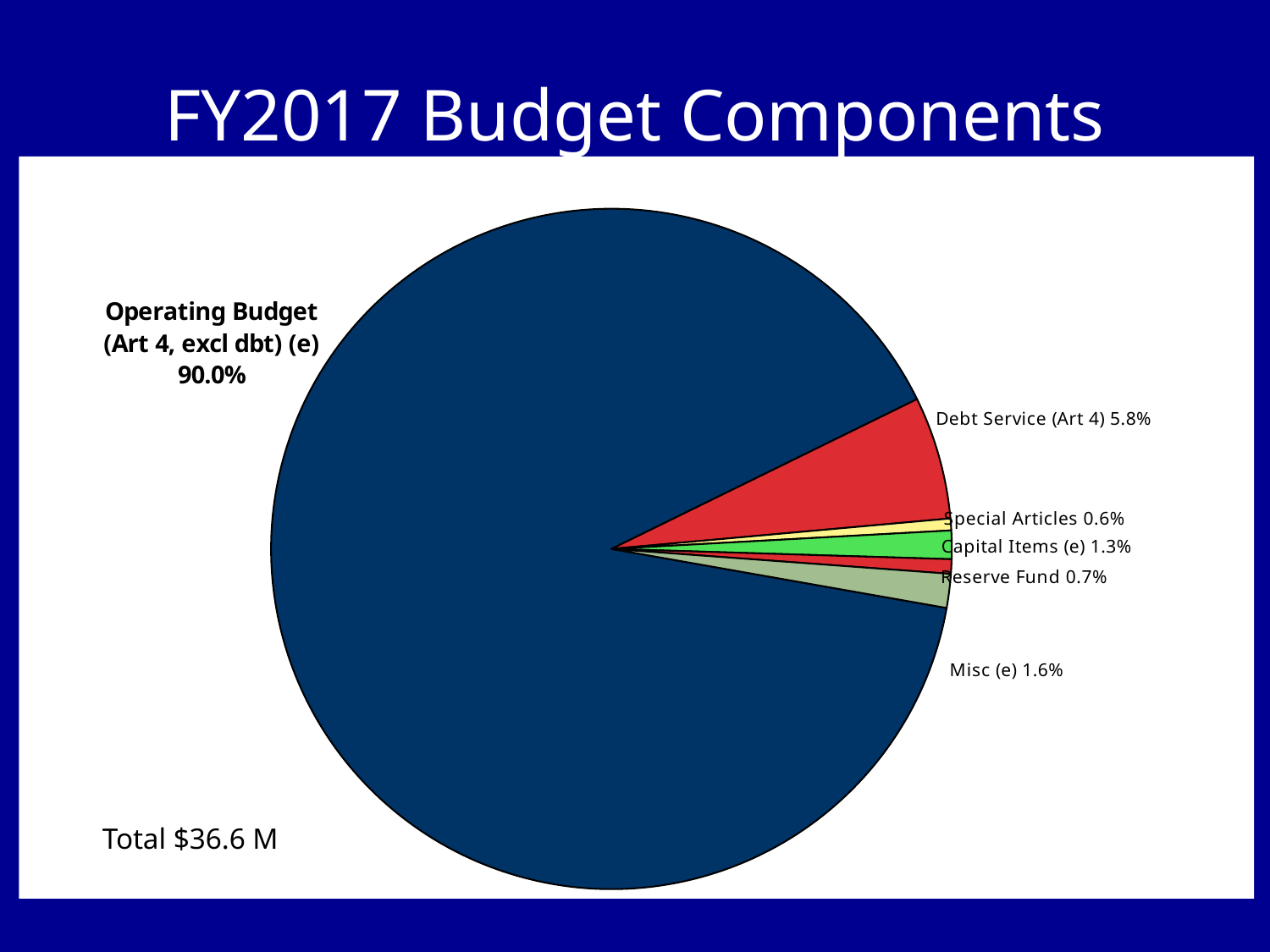
What share of the pie does Debt Service (Art 4) represent? 5.8% Which is larger, Capital Items (e) or Reserve Fund? Capital Items (e) What total amount is stated on the slide for the budget? $36.6 M Which slice of the pie is the largest? Operating Budget (Art 4, excl dbt) (e) Which slice of the pie is the smallest? Special Articles What is the value shown for Misc (e)? 1.6% What is the value shown for Reserve Fund? 0.7% What share of the pie does Operating Budget (Art 4, excl dbt) (e) represent? 90.0% What is the value shown for Capital Items (e)? 1.3% How many slices does the pie chart have? 6 What kind of chart is shown on the slide? Pie chart What is the difference in percentage points between Debt Service (Art 4) and Misc (e)? 4.2